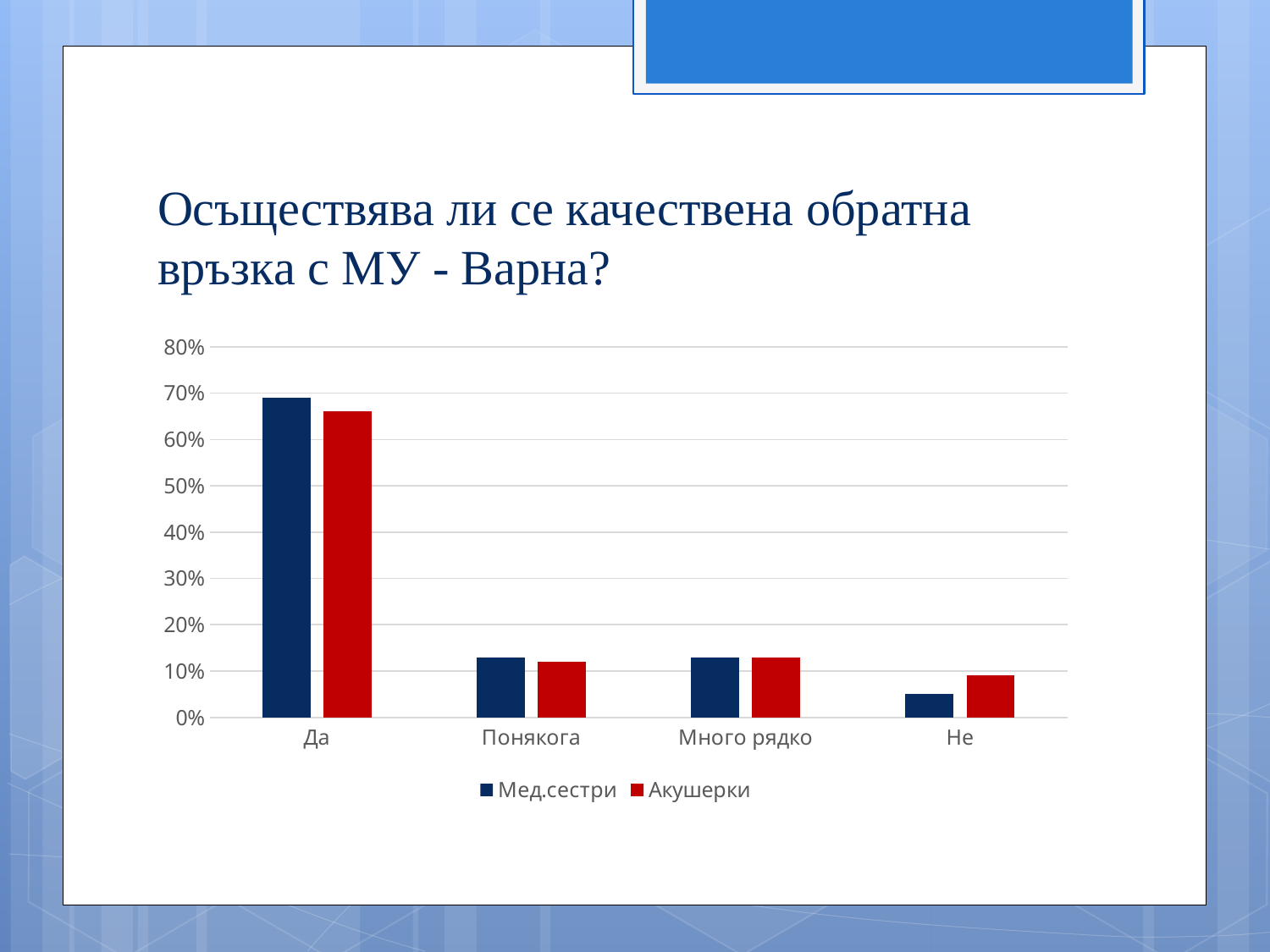
What colour are the bars for the Акушерки series? red How many categories are shown on the x axis? 4 Is the value for Мед.сестри in the category Не greater or less than 10%? less How many series does the legend list? 2 Is the value for Мед.сестри in the category Да greater or less than 60%? greater Which category has the highest value for Мед.сестри? Да Which category has the lowest value for Акушерки? Не Which category has the lowest value for Мед.сестри? Не Which category has the highest value for Акушерки? Да Is the value for Акушерки in the category Да greater or less than 70%? less What kind of chart is shown on the slide? bar chart For the category Не, which series has the larger value, Мед.сестри or Акушерки? Акушерки